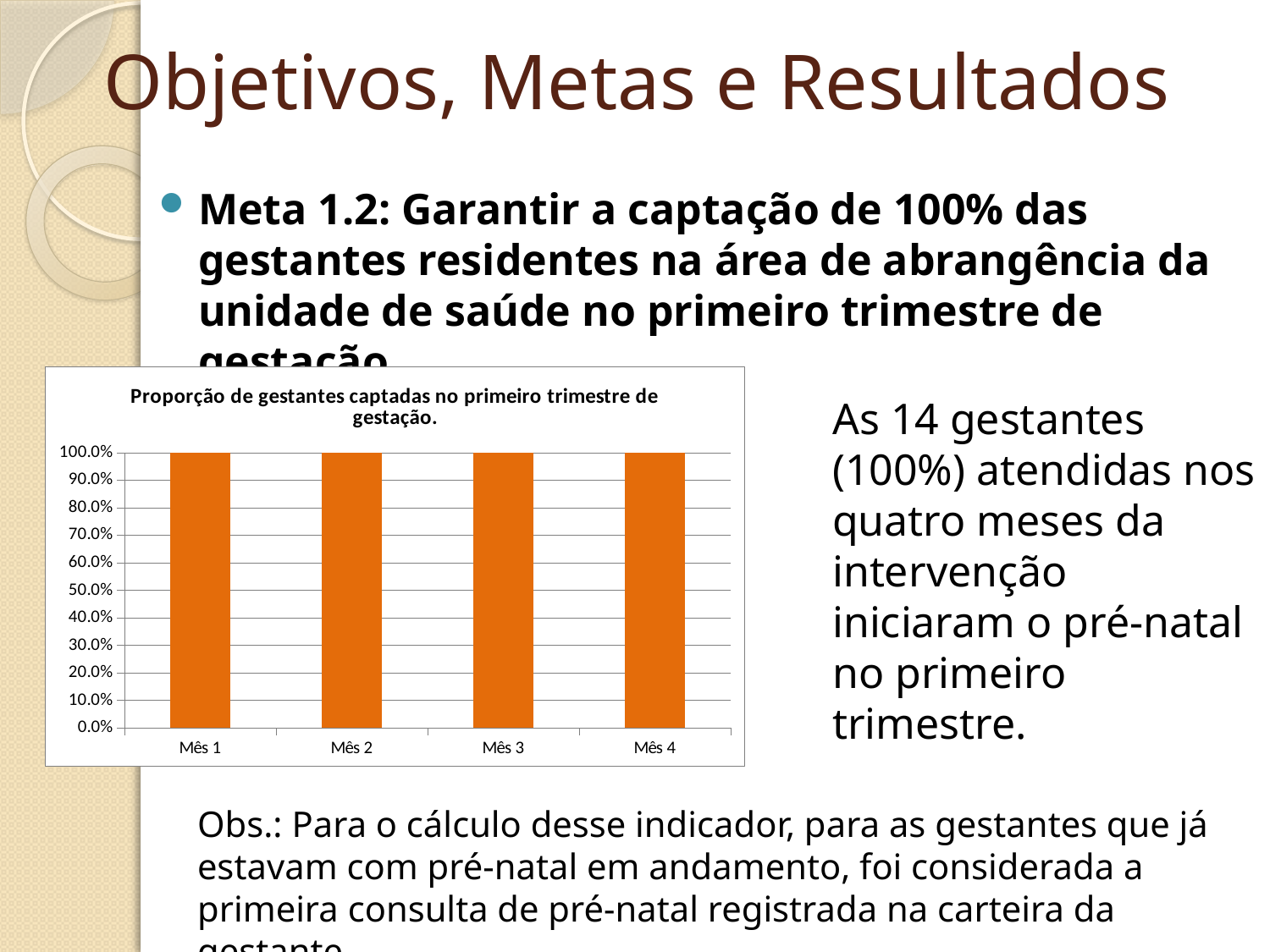
Is the value for Mês 2 greater or less than 50.0%? greater What is the value for Mês 3 in the chart? 100.0% How many categories (months) are plotted on the x axis of the chart? 4 What is the value for Mês 4 in the chart? 100.0% What is the difference between the values for Mês 1 and Mês 4? 0.0% Is the value for Mês 4 greater or less than 90.0%? greater Do the values rise, fall, or stay flat from Mês 1 to Mês 4? stay flat What is the value for Mês 1 in the chart? 100.0% What is the label of the first category on the x axis? Mês 1 What colour are the bars in the chart? orange What kind of chart is shown on the slide? bar chart What is the title of the chart? Proporção de gestantes captadas no primeiro trimestre de gestação.